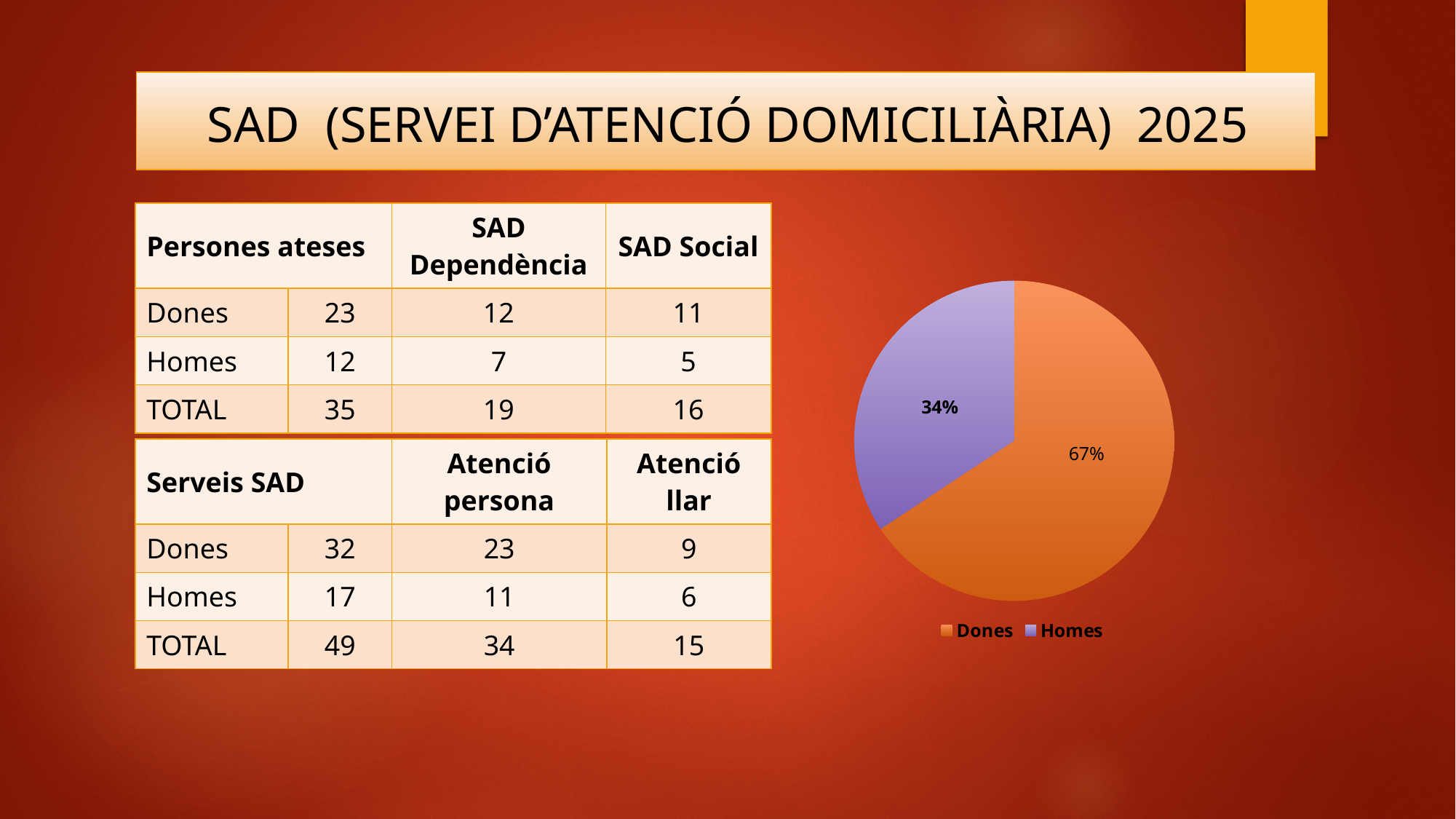
Which is larger in the pie chart, Dones or Homes? Dones What colour is the Homes slice in the pie chart? purple Which slice of the pie chart is the largest? Dones What share of the pie chart does Dones represent? 67% How many slices does the pie chart have? 2 What colour is the Dones slice in the pie chart? orange What share of the pie chart does Homes represent? 34% Which slice of the pie chart is the smallest? Homes How many entries does the pie chart legend list? 2 What kind of chart is shown on the slide? pie chart What is the difference in percentage points between the Dones and Homes slices of the pie chart? 33